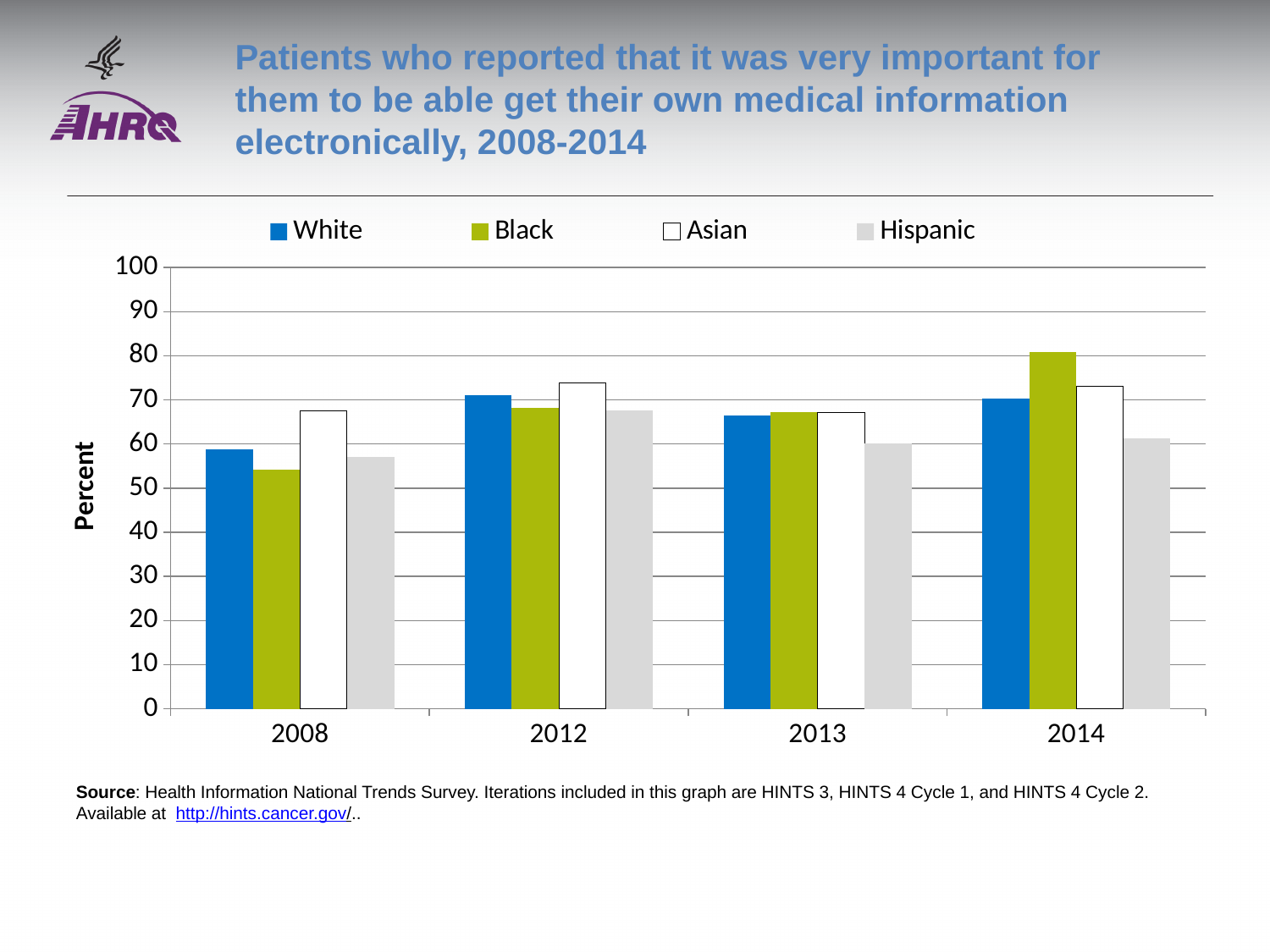
What kind of chart is shown on the slide? bar chart Is the value for Black in 2014 greater or less than 70? greater Is the value for Asian in 2008 greater or less than 60? greater Is the value for Hispanic in 2013 greater or less than 70? less In 2014, which is larger, the value for White or the value for Hispanic? White What is the label on the y axis? Percent Which group has the lowest value in 2014? Hispanic Which group has the lowest value in 2008? Black How many series does the legend list? 4 Does the value for Black rise or fall from 2008 to 2014? rise How many years are shown on the x axis? 4 Which group has the highest value in 2014? Black